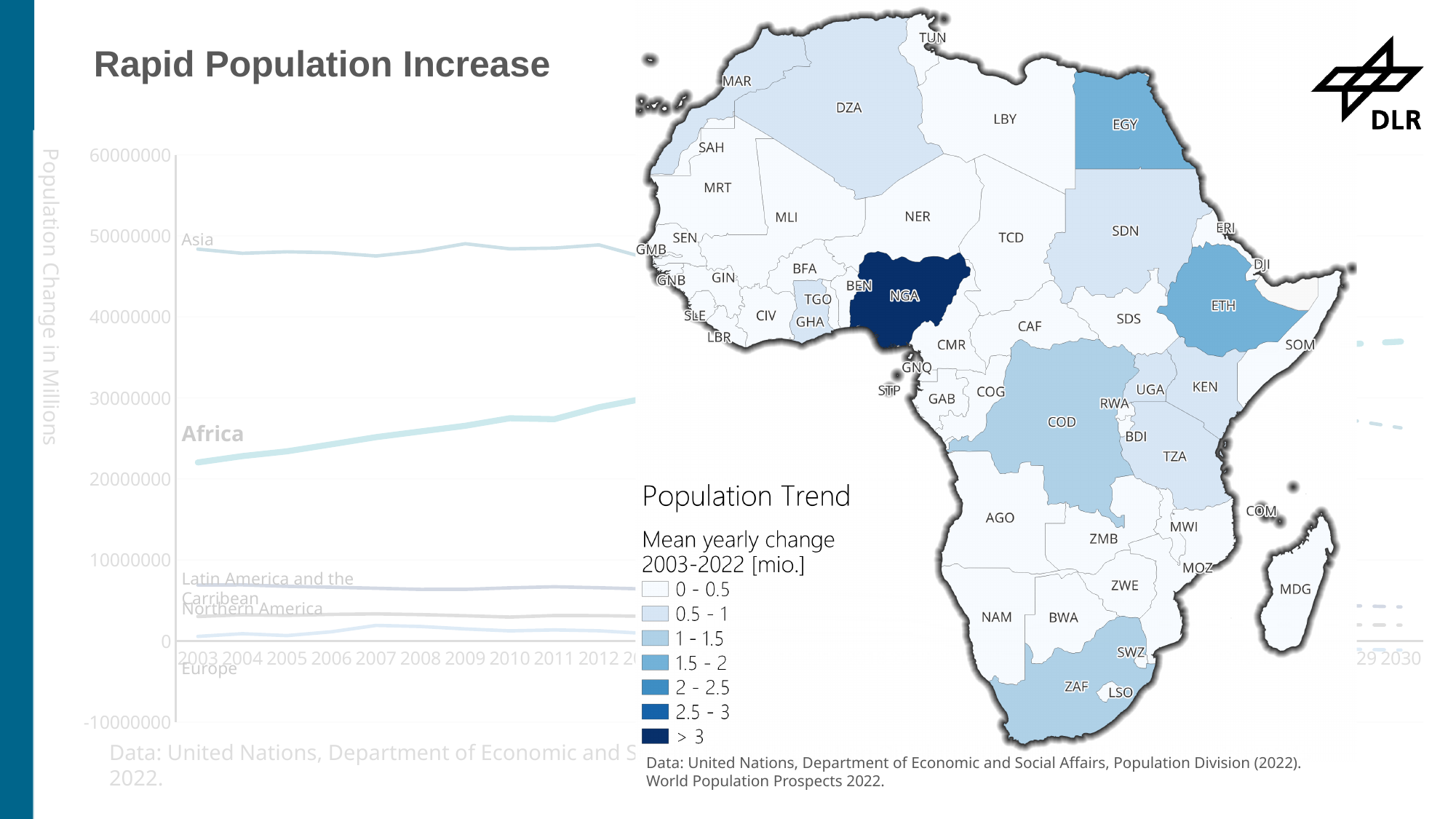
How many regions are plotted in the line chart on the left? 5 On the Africa map, which country falls in the darkest class of mean yearly population change? NGA In the line chart on the left, is the value for Asia in 2003 greater or less than 40000000? greater In the line chart on the left, does the Africa line rise or fall from 2003 to 2012? rise What kind of chart is shown on the left side of the slide? line chart In the line chart on the left, is the value for Africa in 2010 greater or less than 30000000? less In the line chart on the left, is the value for Africa in 2003 greater or less than 20000000? greater On the Africa map, which legend range does NGA fall into? > 3 In the line chart on the left, which region has the highest population change across the years shown? Asia In the line chart on the left, which region has the lowest population change? Europe How many classes does the legend of the Africa map list? 7 In the line chart on the left, which is larger in 2003: Latin America and the Caribbean or Northern America? Latin America and the Caribbean